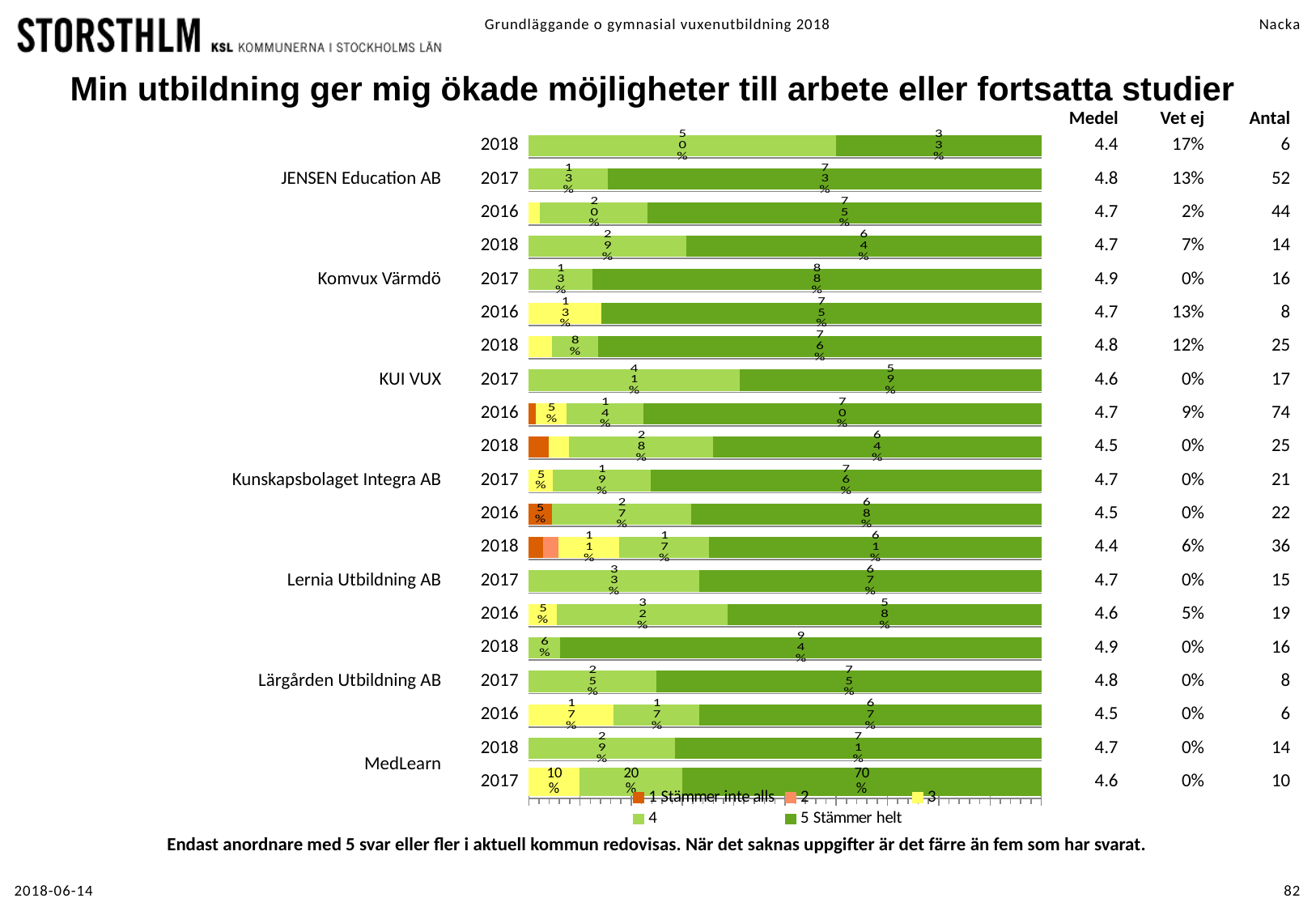
How many bars are plotted in the chart? 20 How many series does the legend list? 5 Which bar has the highest value for '5 Stämmer helt'? Lärgården Utbildning AB 2018 Which bar has the lowest value for '5 Stämmer helt'? JENSEN Education AB 2018 What is the value of '5 Stämmer helt' for Komvux Värmdö in 2017? 88% What kind of chart is shown on the slide? Stacked bar chart Which is larger: the '4' value for Lernia Utbildning AB in 2017 or in 2016? 2017 What is the value of '5 Stämmer helt' for MedLearn in 2017? 70% What is the first legend entry of the chart? 1 Stämmer inte alls What is the value of '5 Stämmer helt' for Lärgården Utbildning AB in 2018? 94% What is the value of '4' for JENSEN Education AB in 2018? 50% What is the difference between the '5 Stämmer helt' values for KUI VUX in 2017 and 2018? 17 percentage points